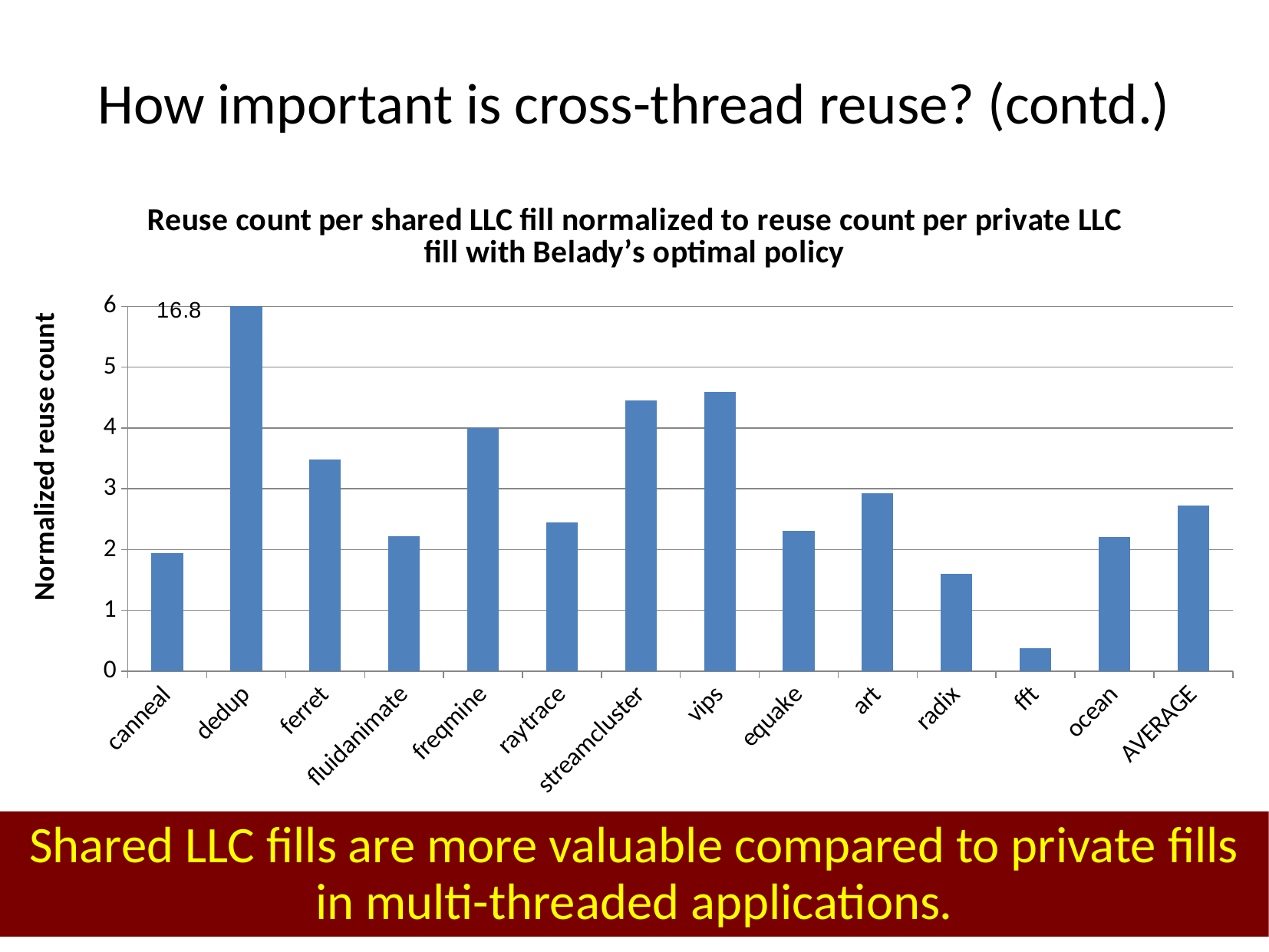
What is the normalized reuse count for dedup? 16.8 Is the value for ferret greater or less than 3? greater Which category has the highest normalized reuse count? dedup Is the value for fft greater or less than 1? less Which is larger, the value for ferret or the value for raytrace? ferret What is the label of the y axis? Normalized reuse count What kind of chart is shown on the slide? bar chart How many categories are plotted along the x axis? 14 Is the value for vips greater or less than 4? greater Which is larger, the value for art or the value for equake? art Which category has the lowest normalized reuse count? fft